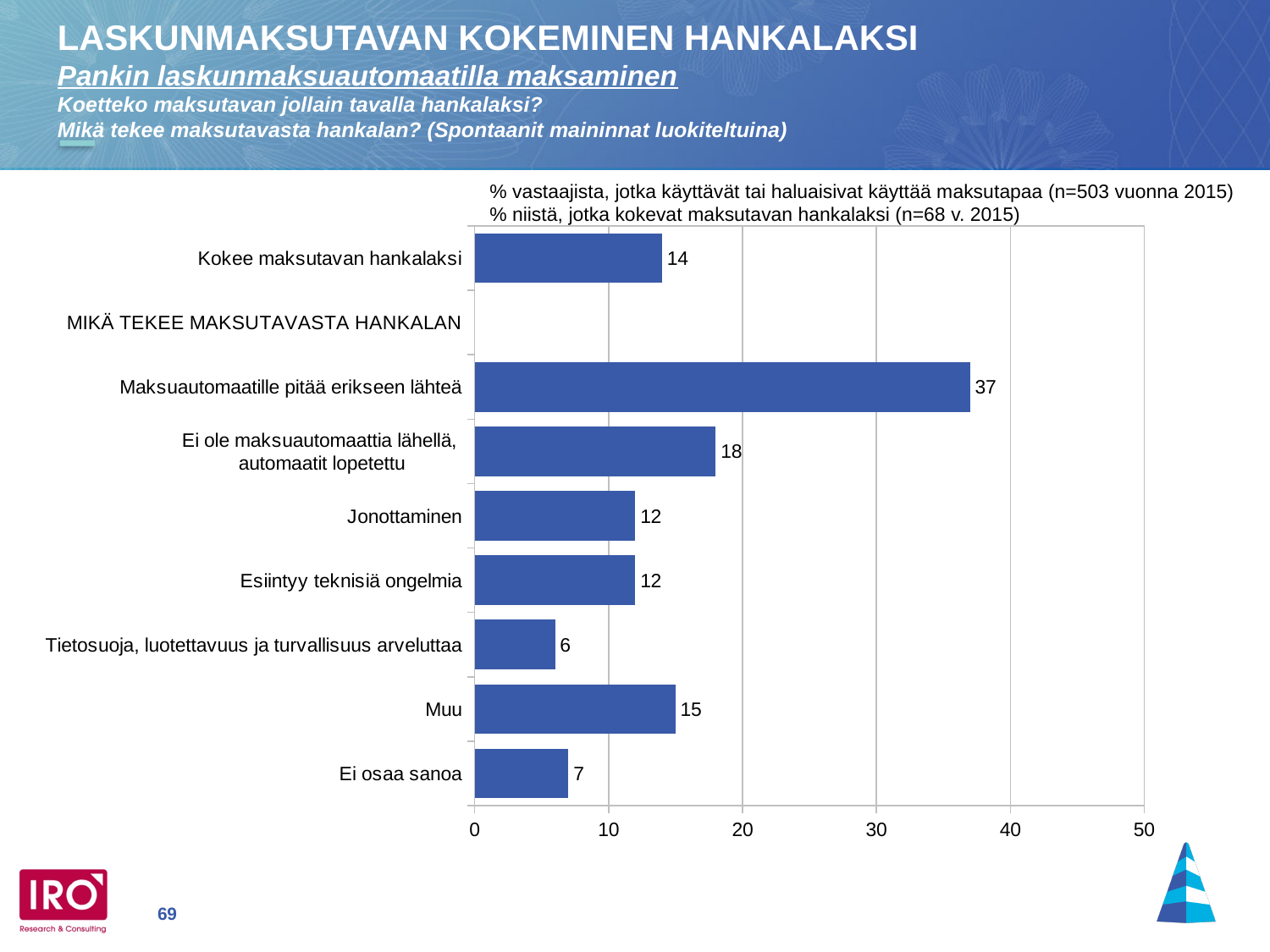
What is the value for "Ei osaa sanoa"? 7 Which category has the highest value? Maksuautomaatille pitää erikseen lähteä What is the difference between the values for "Maksuautomaatille pitää erikseen lähteä" and "Ei ole maksuautomaattia lähellä, automaatit lopetettu"? 19 What kind of chart is shown on the slide? Bar chart Which is larger, the value for "Muu" or the value for "Jonottaminen"? Muu What is the value for "Muu"? 15 Is the value for "Maksuautomaatille pitää erikseen lähteä" greater or less than 30? greater Which category has the lowest value? Tietosuoja, luotettavuus ja turvallisuus arveluttaa What is the value for "Kokee maksutavan hankalaksi"? 14 What is the value for "Ei ole maksuautomaattia lähellä, automaatit lopetettu"? 18 What is the value for "Maksuautomaatille pitää erikseen lähteä"? 37 How many bars are plotted in the chart? 8